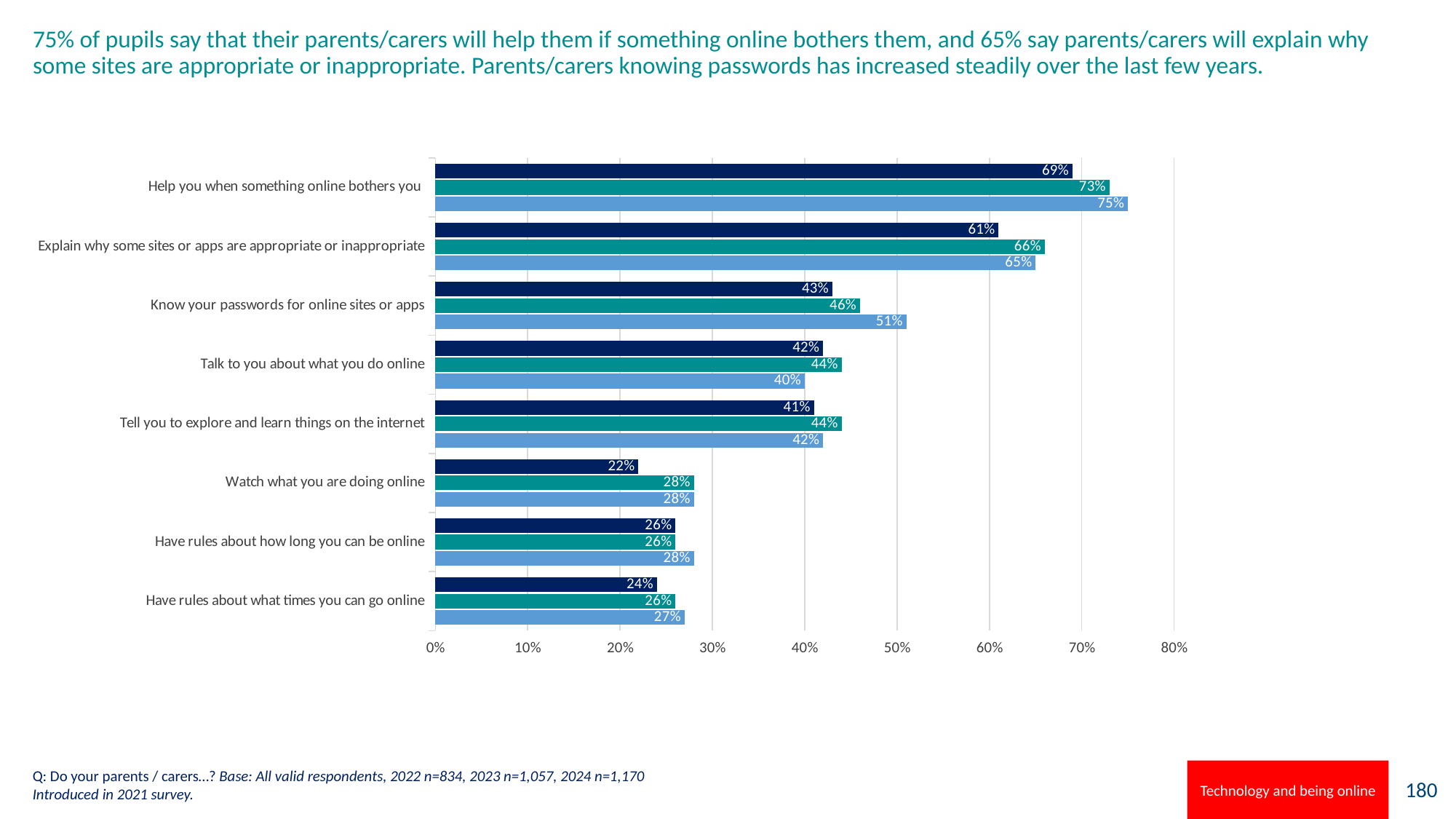
What is the value of the middle (teal) bar for 'Explain why some sites or apps are appropriate or inappropriate'? 66% Which category has the lowest value among the top (dark navy) bars? Watch what you are doing online What is the value of the bottom (light blue) bar for 'Help you when something online bothers you'? 75% For 'Watch what you are doing online', which is larger: the top (dark navy) bar or the middle (teal) bar? the middle (teal) bar How many bars are shown for each category in the chart? 3 How many categories are listed on the vertical axis of the chart? 8 Do the three bars for 'Know your passwords for online sites or apps' rise or fall from the top bar to the bottom bar? rise What is the value of the bottom (light blue) bar for 'Talk to you about what you do online'? 40% What is the difference between the bottom (light blue) bar and the top (dark navy) bar for 'Know your passwords for online sites or apps'? 8% What type of chart is shown on the slide? bar chart What is the value of the top (dark navy) bar for 'Know your passwords for online sites or apps'? 43% Which category has the highest value among the bottom (light blue) bars? Help you when something online bothers you